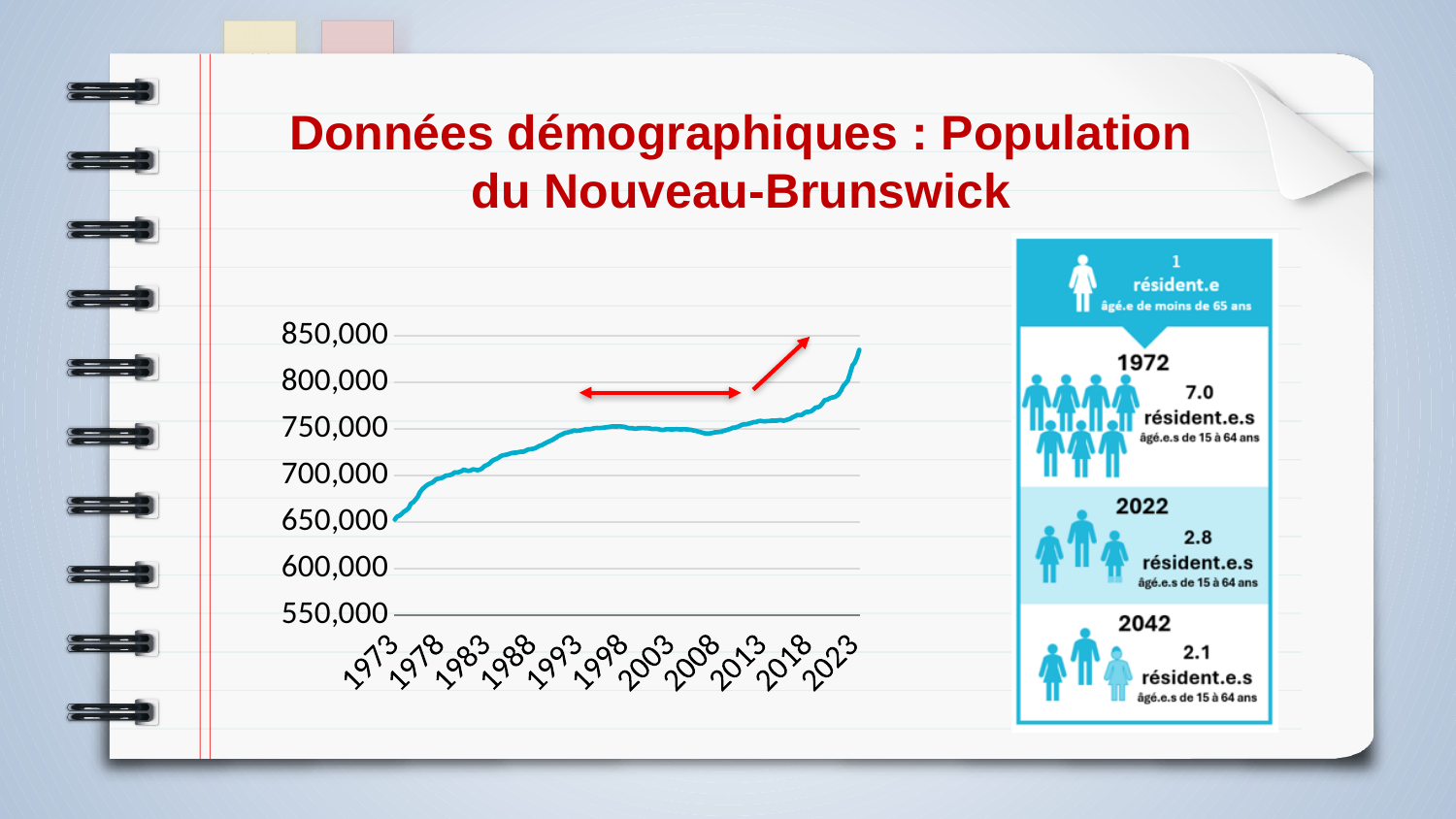
Is the population value for 2003 greater or less than 700,000? greater Which labelled year has the lowest population on the chart? 1973 Is the population value for 2023 greater or less than 800,000? greater What is the lowest value shown on the y axis? 550,000 Which labelled year has the highest population on the chart? 2023 What kind of chart is shown on the slide? line chart Is the population value for 1973 greater or less than 700,000? less Which year has the larger population, 1973 or 2023? 2023 Overall, does the population line rise or fall from 1973 to 2023? rise How many year labels are shown on the x axis? 11 What is the highest value shown on the y axis? 850,000